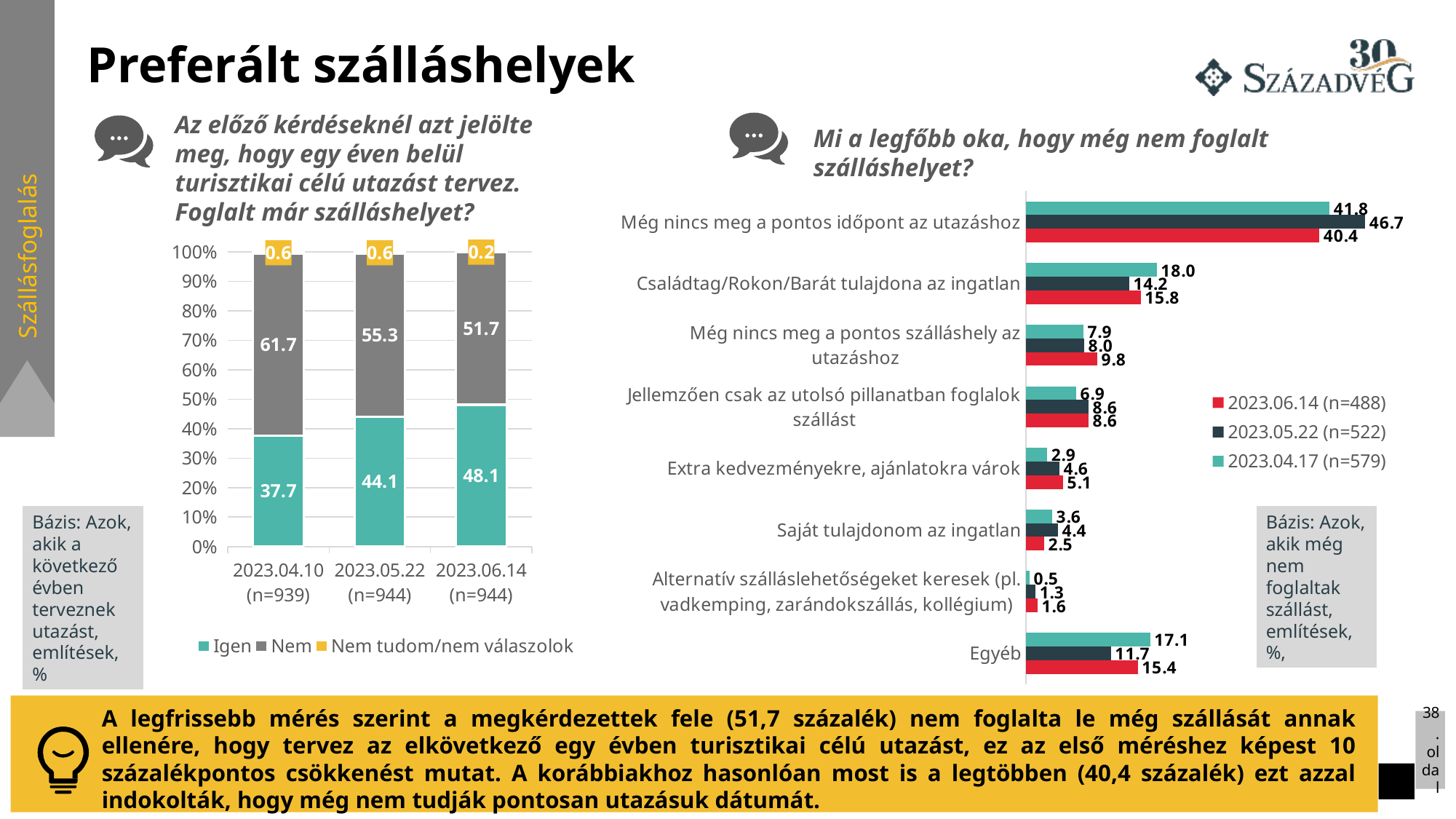
In the right chart (Mi a legfőbb oka, hogy még nem foglalt szálláshelyet?), which category has the highest value in the 2023.05.22 (n=522) series? Még nincs meg a pontos időpont az utazáshoz In the right chart (Mi a legfőbb oka, hogy még nem foglalt szálláshelyet?), which category has the lowest value in the 2023.04.17 (n=579) series? Alternatív szálláslehetőségeket keresek (pl. vadkemping, zarándokszállás, kollégium) In the right chart (Mi a legfőbb oka, hogy még nem foglalt szálláshelyet?), what is the value for 'Még nincs meg a pontos időpont az utazáshoz' in the 2023.06.14 (n=488) series? 40.4 In the right chart (Mi a legfőbb oka, hogy még nem foglalt szálláshelyet?), which is larger for 'Egyéb': the 2023.04.17 (n=579) value or the 2023.05.22 (n=522) value? 2023.04.17 (n=579) What type of chart is the right chart (Mi a legfőbb oka, hogy még nem foglalt szálláshelyet?)? bar chart In the left chart (Foglalt már szálláshelyet?), does the 'Igen' value rise or fall across the three survey dates? rise In the right chart (Mi a legfőbb oka, hogy még nem foglalt szálláshelyet?), how many categories are shown? 8 In the left chart (Foglalt már szálláshelyet?), what is the value of 'Nem' for 2023.04.10 (n=939)? 61.7 In the left chart (Foglalt már szálláshelyet?), how many series does the legend list? 3 In the left chart (Foglalt már szálláshelyet?), what is the value of 'Igen' for 2023.06.14 (n=944)? 48.1 In the left chart (Foglalt már szálláshelyet?), what is the difference between the 'Nem' values for 2023.04.10 and 2023.06.14? 10.0 In the left chart (Foglalt már szálláshelyet?), what is the total of the stacked bar for 2023.05.22 (n=944)? 100.0